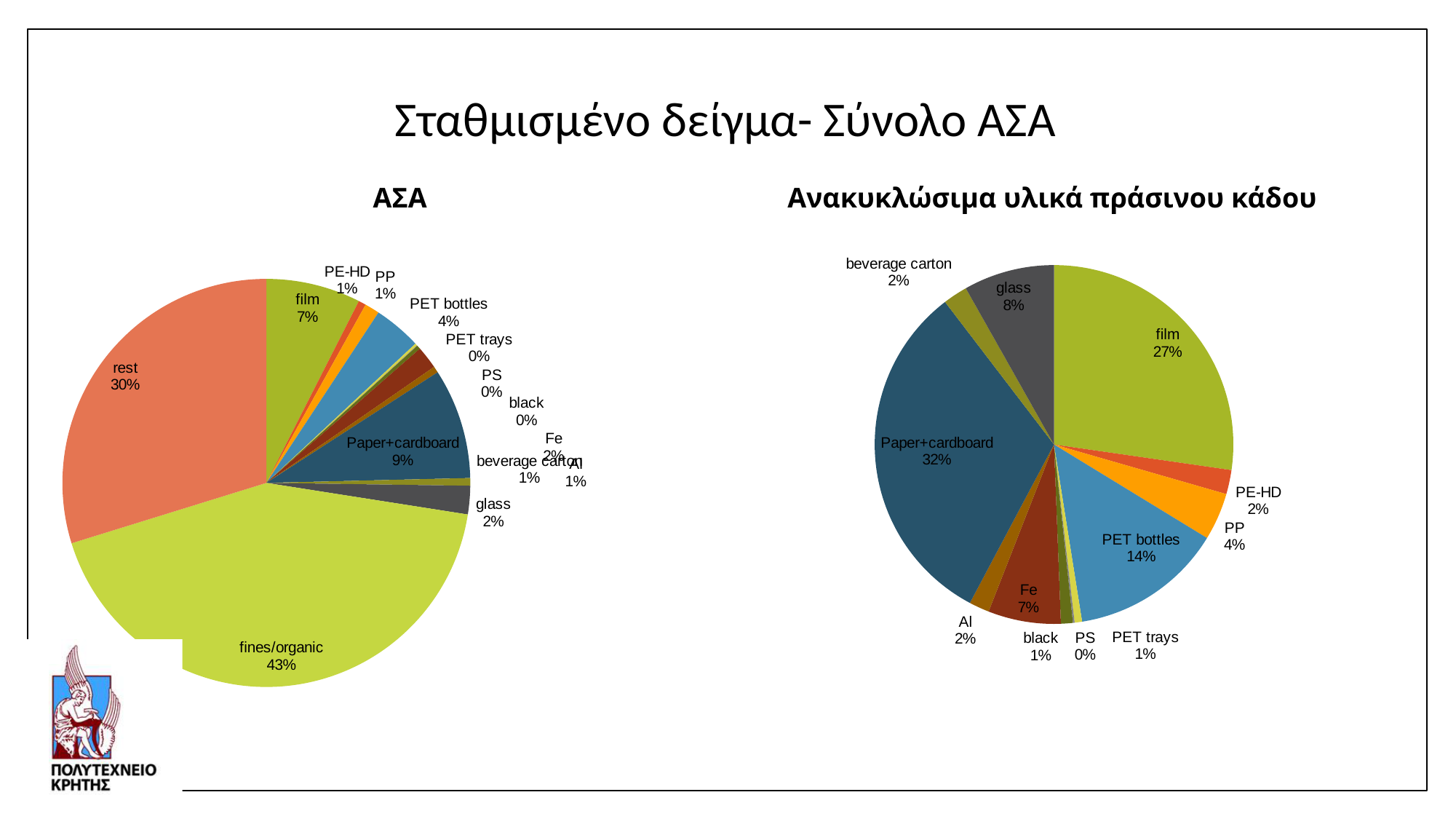
How many categories are shown in the Ανακυκλώσιμα υλικά πράσινου κάδου pie chart? 12 In the Ανακυκλώσιμα υλικά πράσινου κάδου pie chart, what share does PET bottles have? 14% In the ΑΣΑ pie chart, what is the difference between the shares of rest and Paper+cardboard? 21% In the ΑΣΑ pie chart, what share does fines/organic have? 43% In the Ανακυκλώσιμα υλικά πράσινου κάδου pie chart, what is the difference between the shares of film and glass? 19% What type of chart is the ΑΣΑ chart on the left? pie chart In the ΑΣΑ pie chart, which is larger, film or PET bottles? film In the Ανακυκλώσιμα υλικά πράσινου κάδου pie chart, what share does Paper+cardboard have? 32% In the ΑΣΑ pie chart, what share does rest have? 30% In the Ανακυκλώσιμα υλικά πράσινου κάδου pie chart, which is larger, Fe or PP? Fe In the ΑΣΑ pie chart, which category has the largest share? fines/organic In the Ανακυκλώσιμα υλικά πράσινου κάδου pie chart, which category has the largest share? Paper+cardboard